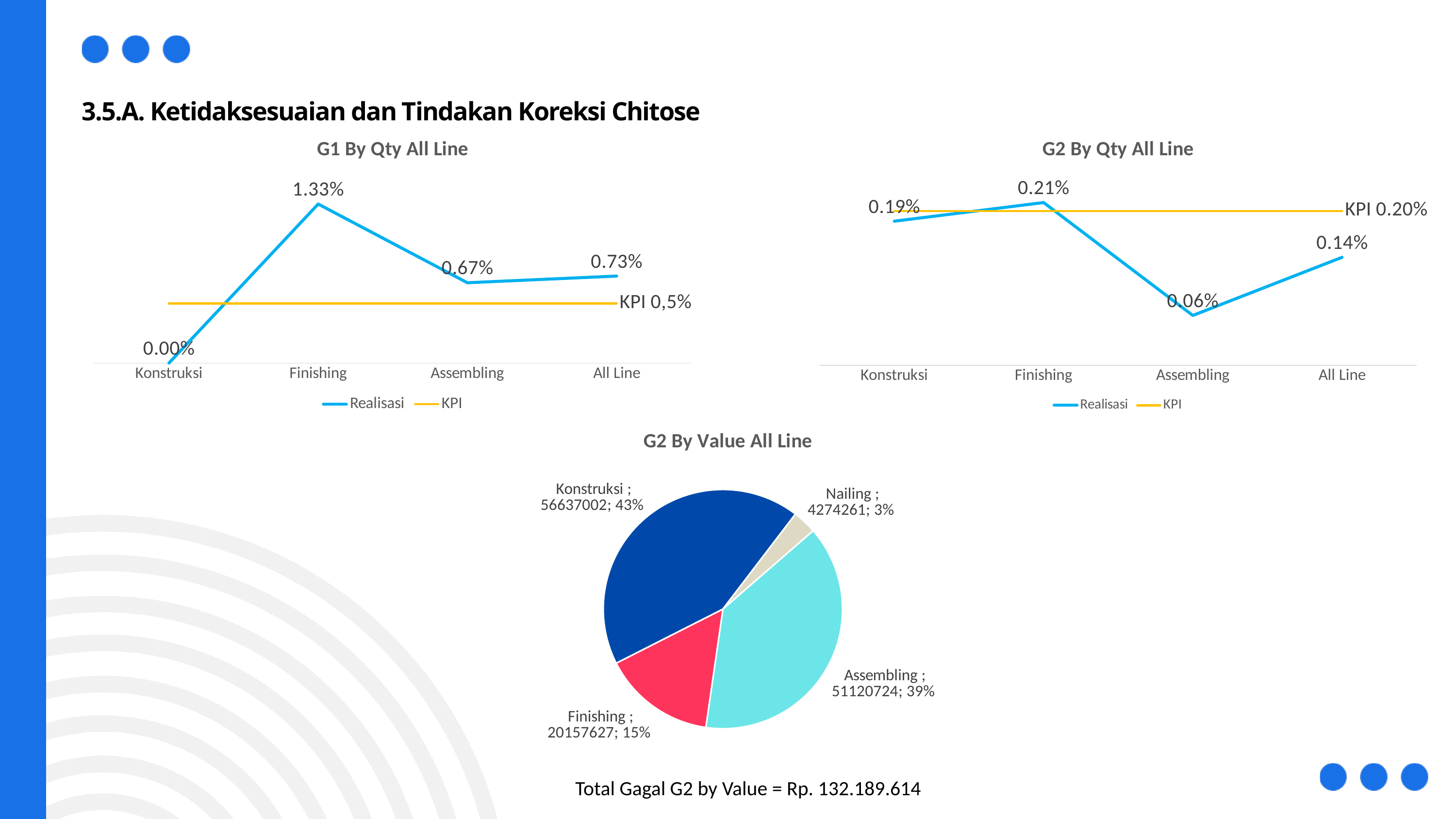
In the 'G1 By Qty All Line' chart, what is the Realisasi value for Finishing? 1.33% In the 'G1 By Qty All Line' chart, which category has the highest Realisasi value? Finishing In the 'G2 By Qty All Line' chart, how many series does the legend list? 2 In the 'G2 By Value All Line' pie chart, what is the value for Finishing? 20157627 In the 'G2 By Value All Line' pie chart, how many slices are there? 4 In the 'G2 By Qty All Line' chart, what is the difference between the Realisasi values for Finishing and Assembling? 0.15% In the 'G1 By Qty All Line' chart, what is the KPI value shown? 0,5% In the 'G2 By Qty All Line' chart, what is the Realisasi value for Assembling? 0.06% In the 'G2 By Value All Line' pie chart, what share does Assembling have? 39% In the 'G2 By Qty All Line' chart, which category has the highest Realisasi value? Finishing In the 'G1 By Qty All Line' chart, which category has the lowest Realisasi value? Konstruksi In the 'G1 By Qty All Line' chart, what type of chart is used? Line chart